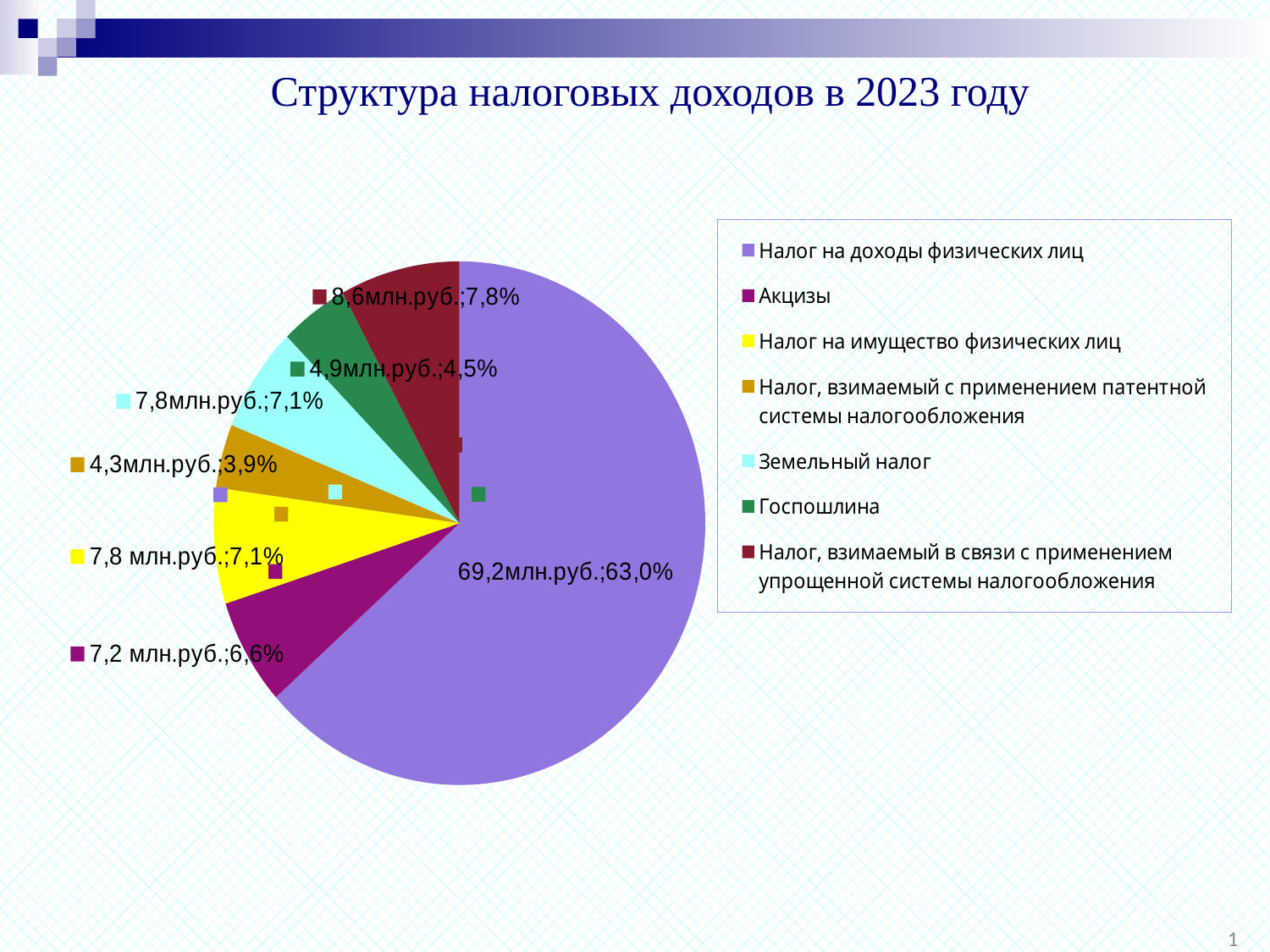
What is the difference in млн.руб. between "Налог, взимаемый в связи с применением упрощенной системы налогообложения" and "Госпошлина"? 3,7 млн.руб. What is the value for "Налог, взимаемый в связи с применением упрощенной системы налогообложения"? 8,6млн.руб. What share of the pie does "Налог на доходы физических лиц" represent? 63,0% How many slices does the pie chart have? 7 What is the value for "Акцизы"? 7,2 млн.руб. What share of the pie does "Госпошлина" represent? 4,5% Which is larger: the value for "Госпошлина" or the value for "Акцизы"? Акцизы What is the title of the chart? Структура налоговых доходов в 2023 году Which category has the largest slice of the pie? Налог на доходы физических лиц What kind of chart is shown on the slide? Pie chart What is the value in млн.руб. for "Налог на доходы физических лиц"? 69,2млн.руб. Which category has the smallest slice of the pie? Налог, взимаемый с применением патентной системы налогообложения